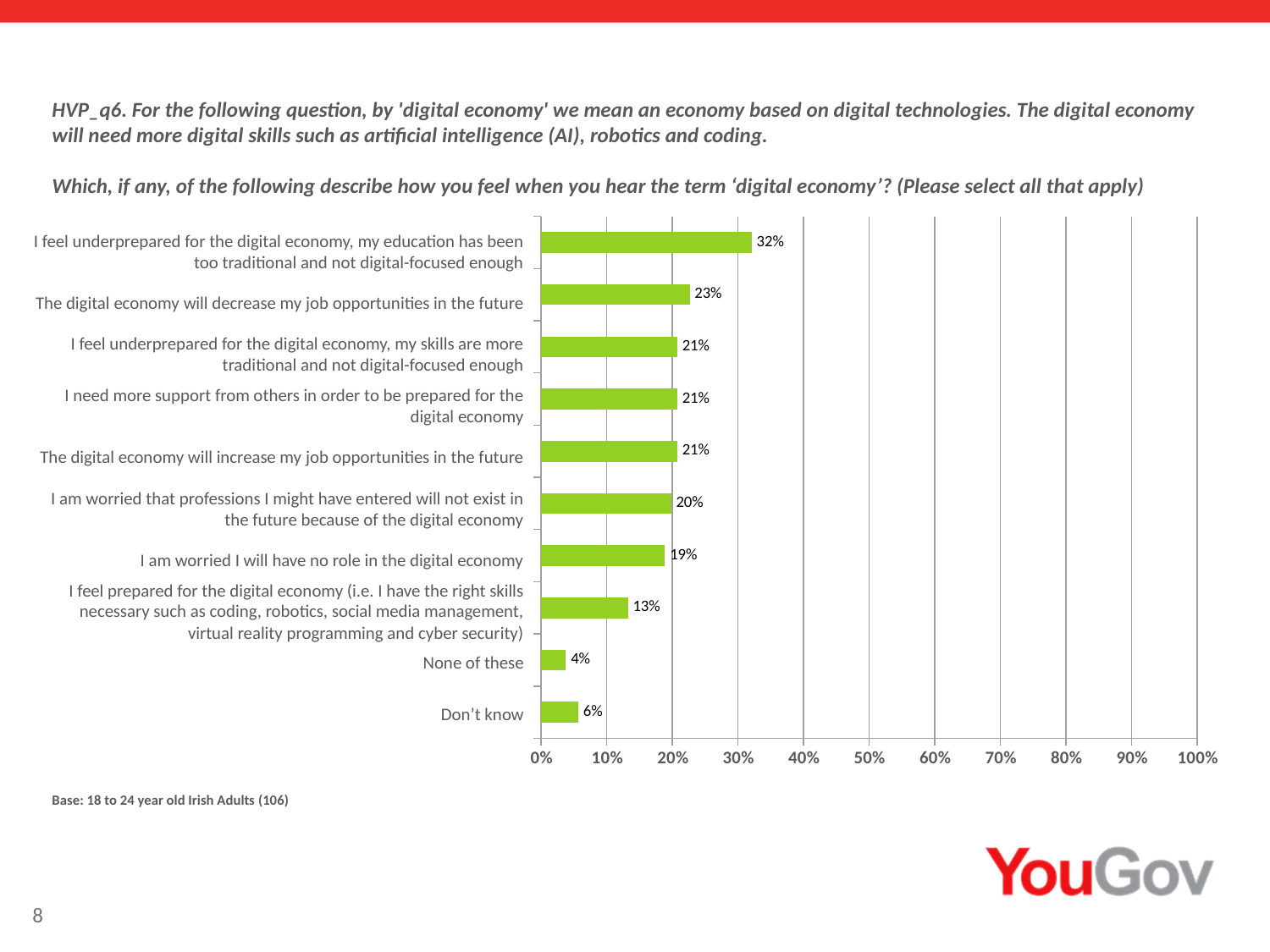
Is the value for 'I am worried that professions I might have entered will not exist in the future because of the digital economy' greater or less than 30%? less What is the base size stated below the chart? 18 to 24 year old Irish Adults (106) What type of chart is shown on the slide? Bar chart How many response options are shown in the chart? 10 What is the difference in percentage points between 'The digital economy will decrease my job opportunities in the future' and 'I am worried I will have no role in the digital economy'? 4 percentage points Which response option has the lowest percentage? None of these Which response option has the highest percentage? I feel underprepared for the digital economy, my education has been too traditional and not digital-focused enough What percentage of respondents said they feel underprepared for the digital economy because their education has been too traditional and not digital-focused enough? 32% What percentage of respondents said the digital economy will decrease their job opportunities in the future? 23% What percentage of respondents said they feel prepared for the digital economy? 13% Which is larger: the percentage for 'None of these' or the percentage for 'Don't know'? Don't know What percentage of respondents answered 'Don't know'? 6%